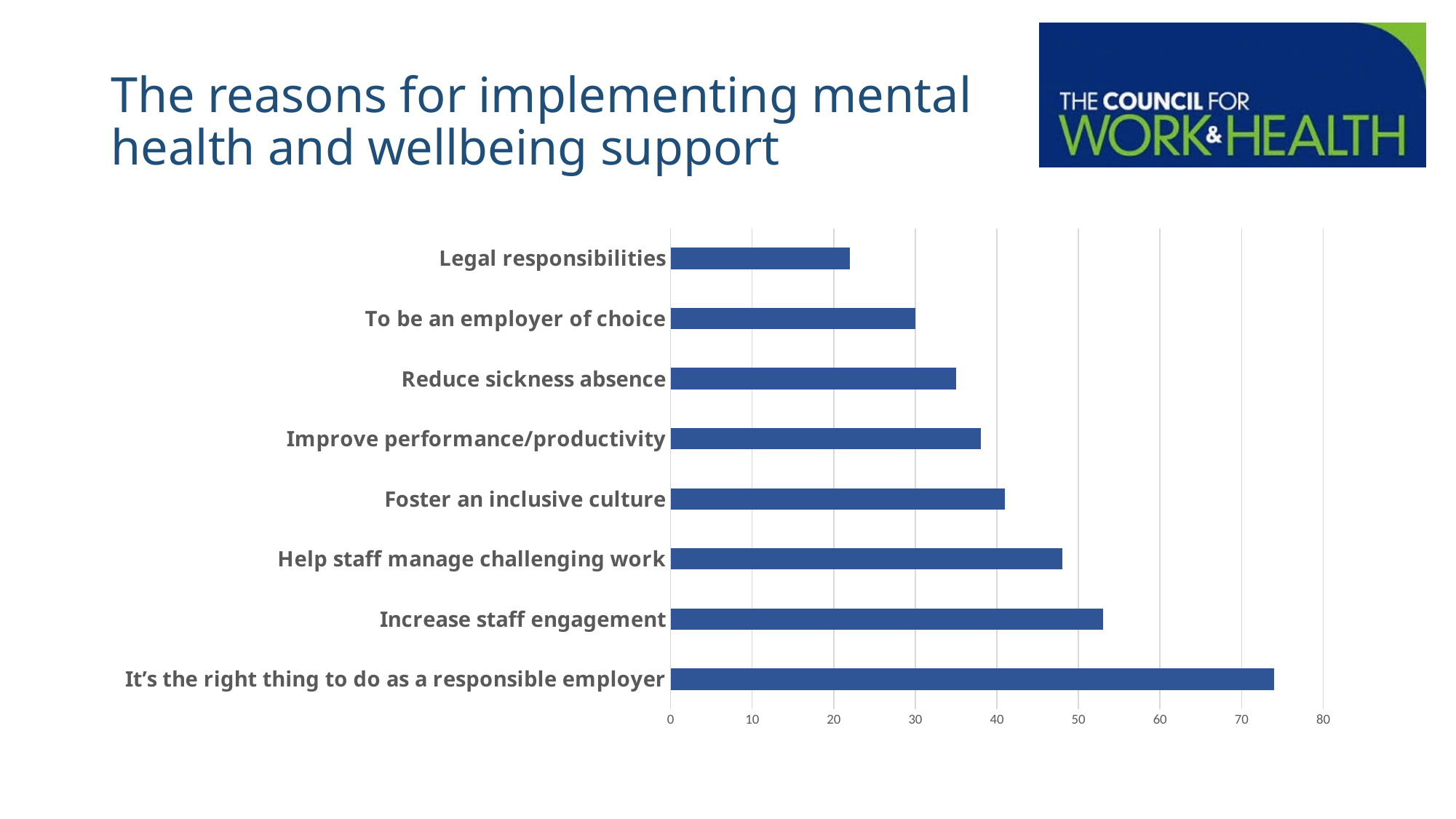
Which has the larger value: "Reduce sickness absence" or "Increase staff engagement"? Increase staff engagement Is the value for "It's the right thing to do as a responsible employer" greater or less than 70? greater Is the value for "Increase staff engagement" greater or less than 50? greater Is the value for "Help staff manage challenging work" greater or less than 50? less What kind of chart is shown on the slide? bar chart Which reason has the highest value in the chart? It's the right thing to do as a responsible employer How many categories (reasons) are plotted in the chart? 8 What is the maximum value shown on the horizontal axis of the chart? 80 Which has the larger value: "Legal responsibilities" or "Improve performance/productivity"? Improve performance/productivity Which reason has the lowest value in the chart? Legal responsibilities